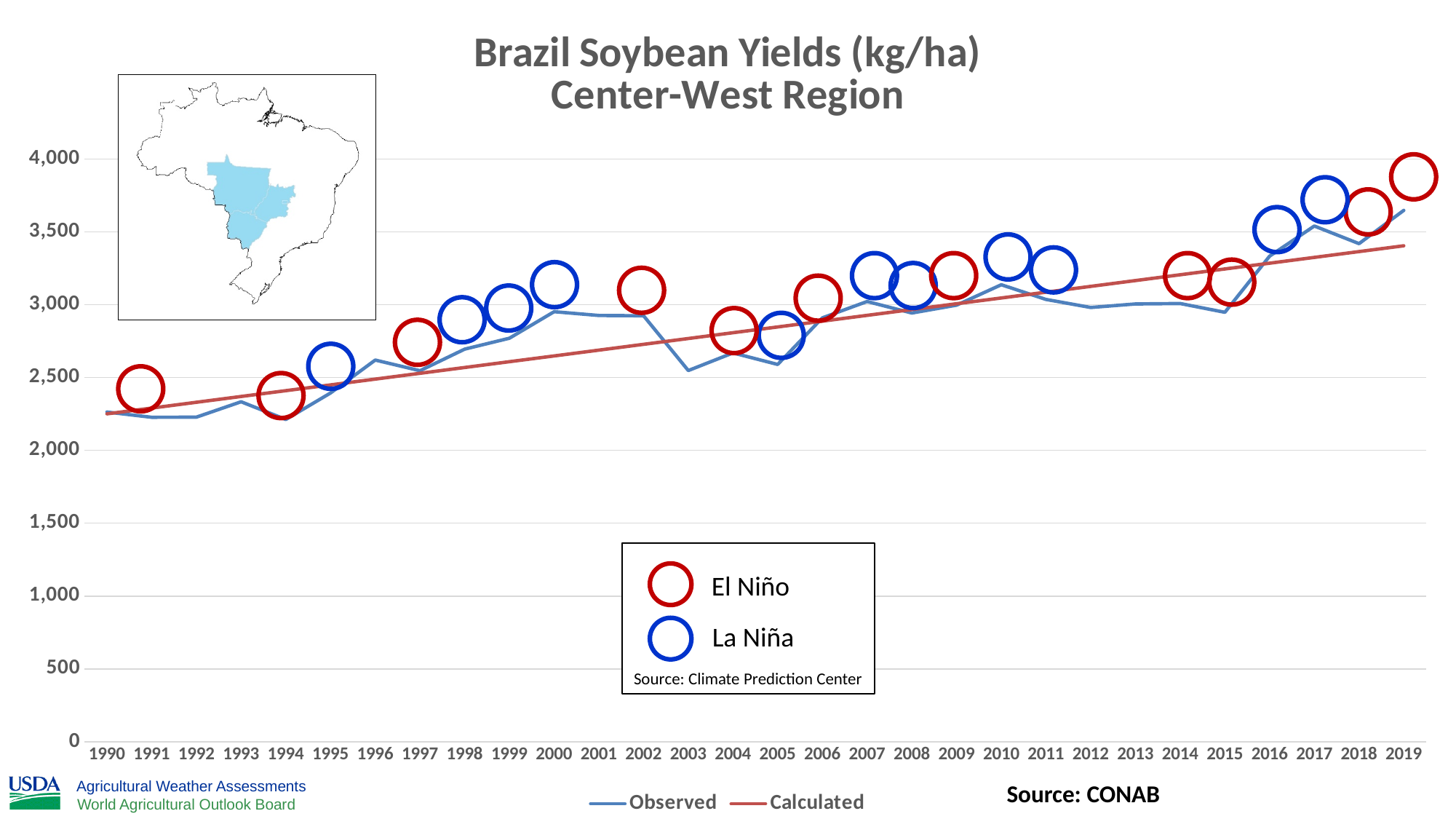
Is the Observed value for 1990 greater or less than 2,500? less Is the Observed value for 2019 greater or less than 3,500? greater Is the Observed value for 2003 greater or less than 3,000? less How many years are plotted along the x axis? 30 Which year has the larger Observed yield, 2002 or 2003? 2002 Does the Observed yield generally rise or fall from 1990 to 2019? rise What is the title of the chart? Brazil Soybean Yields (kg/ha) Center-West Region What kind of chart is shown on the slide? line chart How many series does the legend at the bottom of the chart list? 2 In which year is the Observed yield highest? 2019 What colour are the circles marking El Niño years? red